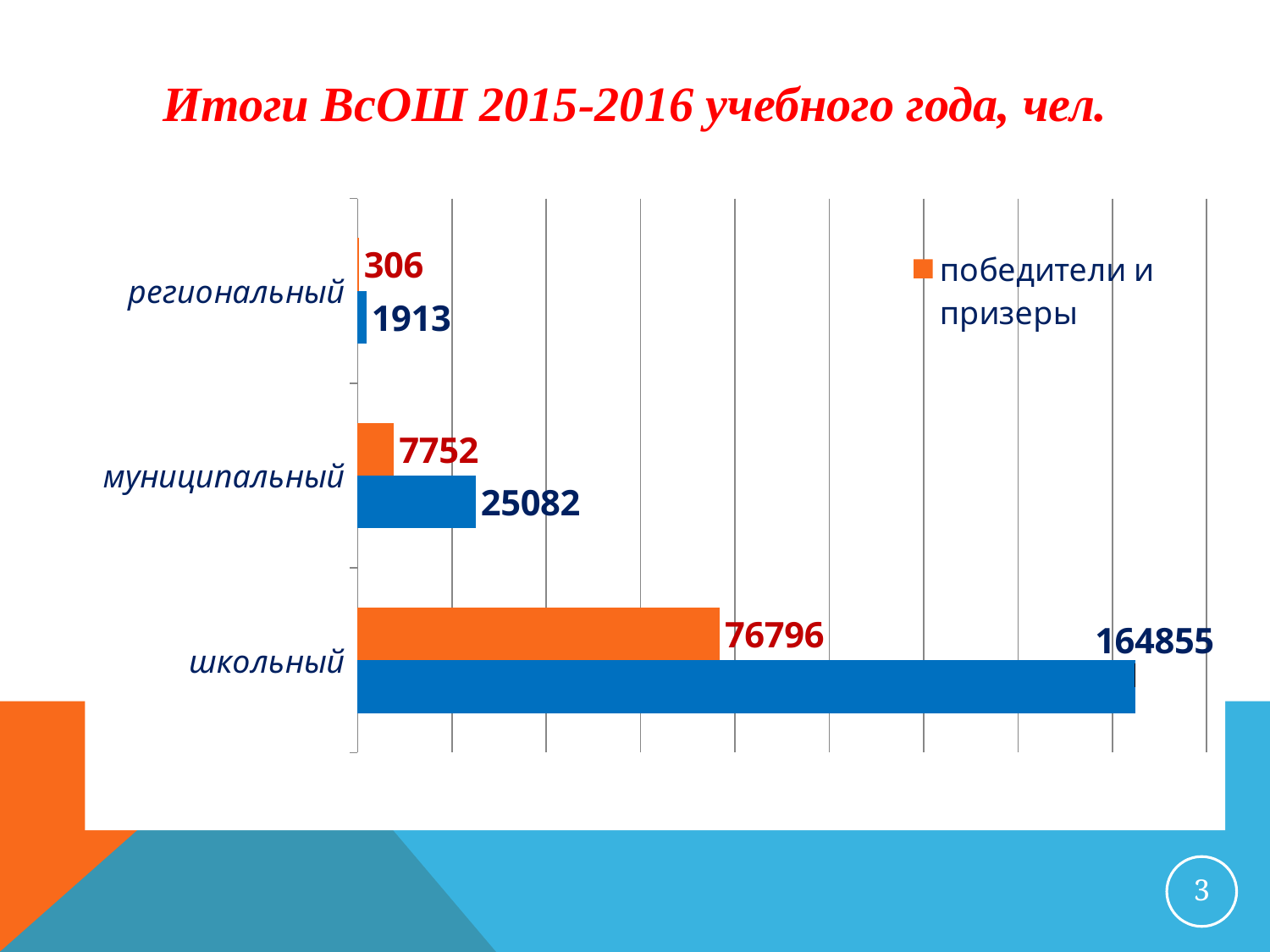
How many levels (categories) are shown in the chart? 3 For the муниципальный level, what is the difference between the blue bar value and the победители и призеры value? 17330 What is the value of the blue bar for the муниципальный level? 25082 Which level has the lowest value for the blue series? региональный Which is larger: победители и призеры for муниципальный or the blue bar for региональный? победители и призеры for муниципальный What is the title of the slide? Итоги ВсОШ 2015-2016 учебного года, чел. What is the value of the blue bar for the региональный level? 1913 What is the value of победители и призеры for the школьный level? 76796 What kind of chart is shown on the slide? bar chart For the школьный level, what is the difference between the blue bar value and the победители и призеры value? 88059 What is the value of победители и призеры for the региональный level? 306 Which level has the highest value for победители и призеры? школьный